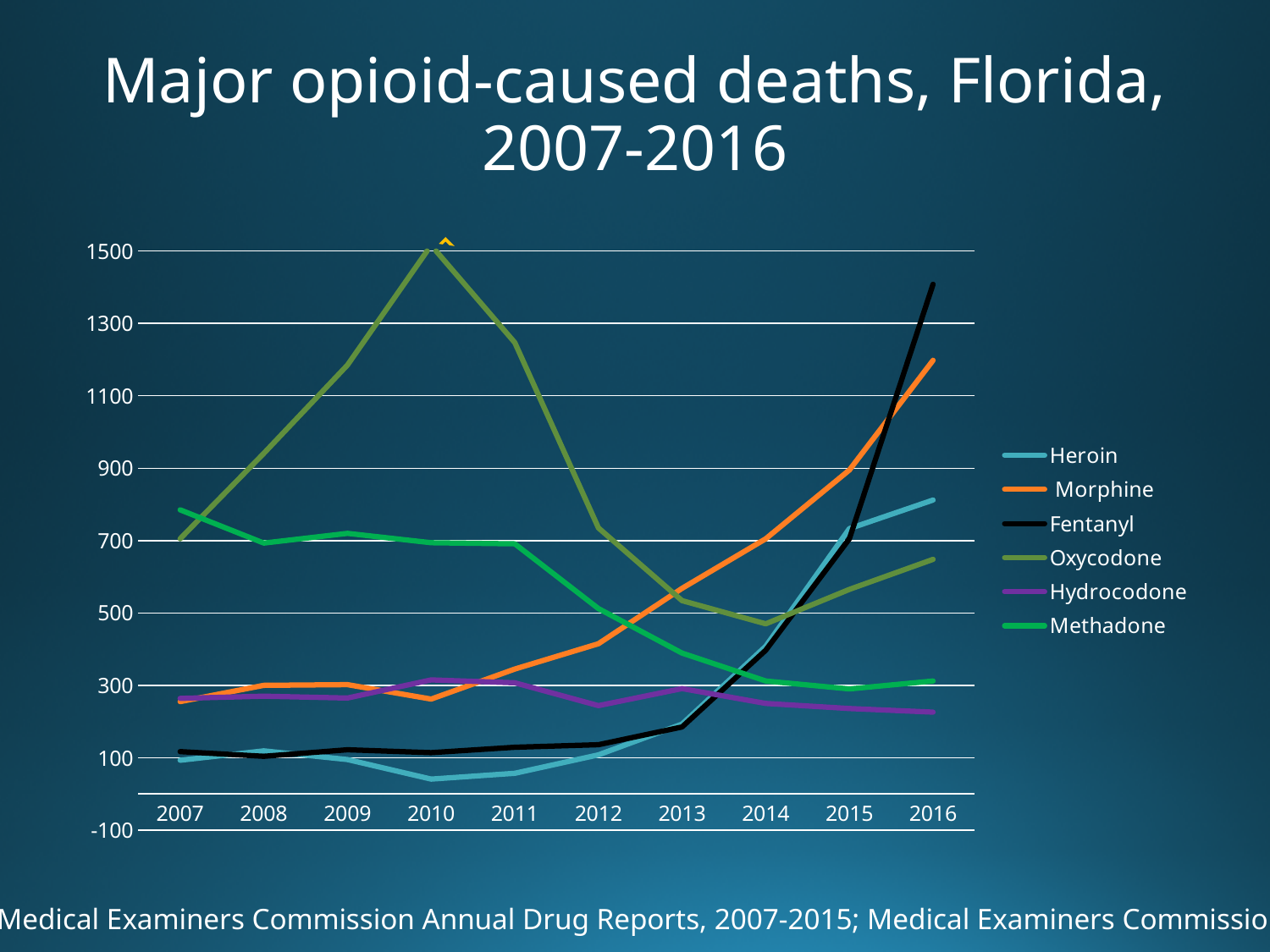
Is the value for Fentanyl in 2016 greater or less than 1300? greater What is the title of the chart? Major opioid-caused deaths, Florida, 2007-2016 Which series has the highest value in 2010? Oxycodone Is the value for Oxycodone in 2010 greater or less than 1300? greater Does the Fentanyl line rise or fall from 2007 to 2016? Rises In 2016, which is larger: Morphine or Heroin? Morphine Is the value for Hydrocodone in 2016 greater or less than 300? less Which series has the lowest value in 2010? Heroin What kind of chart is shown on the slide? Line chart Which series has the highest value in 2016? Fentanyl How many series does the legend list? 6 How many years are shown along the x axis? 10